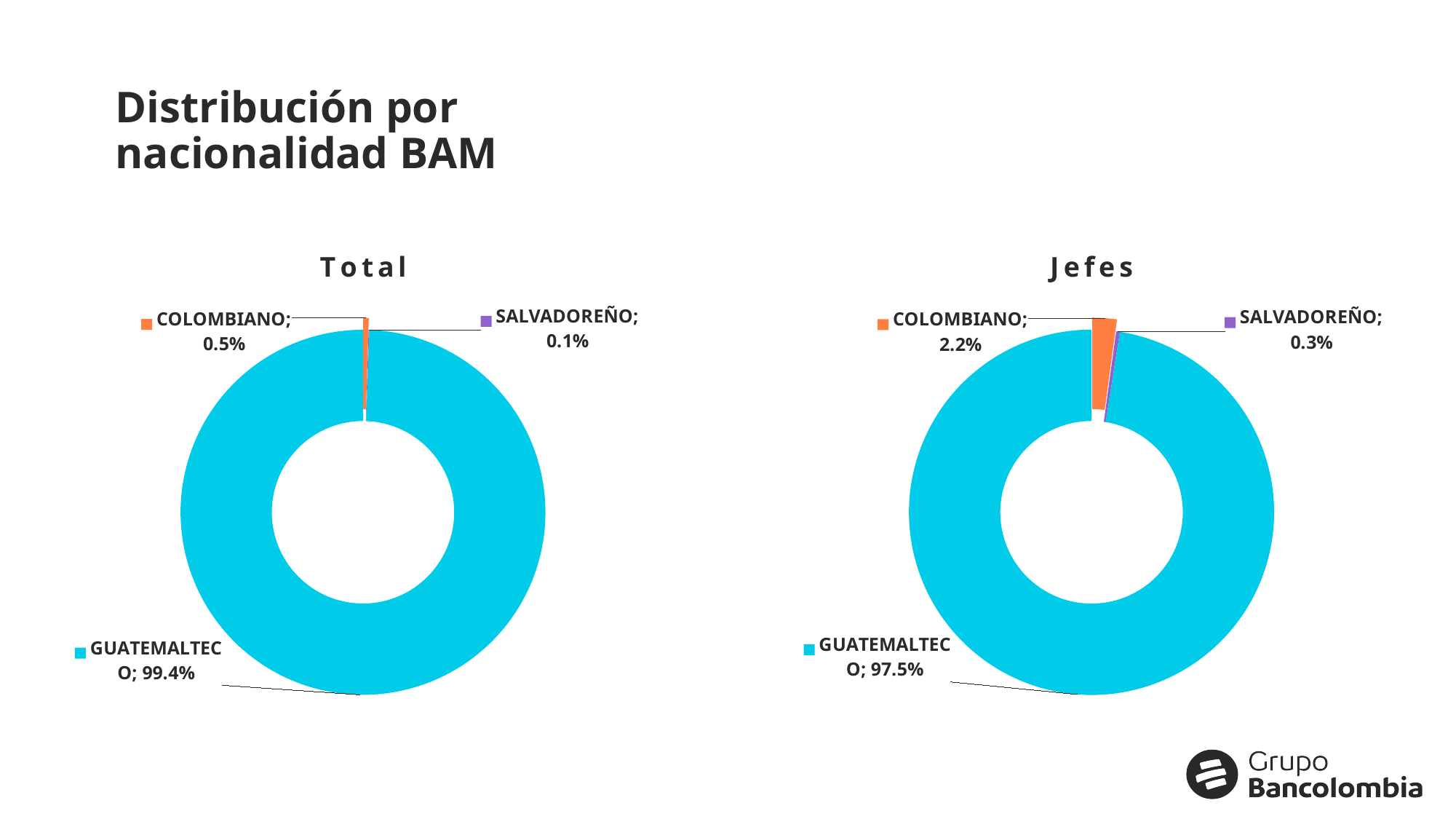
In the 'Jefes' chart, what share does GUATEMALTECO have? 97.5% In the 'Total' chart, which nationality has the largest share? GUATEMALTECO In the 'Jefes' chart, what share does COLOMBIANO have? 2.2% What kind of chart is the 'Jefes' chart? Doughnut (pie) chart In the 'Total' chart, what share does SALVADOREÑO have? 0.1% In the 'Jefes' chart, which nationality has the smallest share? SALVADOREÑO How many categories does the 'Total' chart show? 3 In the 'Jefes' chart, what share does SALVADOREÑO have? 0.3% In the 'Total' chart, what share does COLOMBIANO have? 0.5% In the 'Total' chart, what share does GUATEMALTECO have? 99.4% Is the COLOMBIANO share larger in the 'Total' chart or the 'Jefes' chart? Jefes In the 'Jefes' chart, what is the difference between the COLOMBIANO and SALVADOREÑO shares? 1.9%